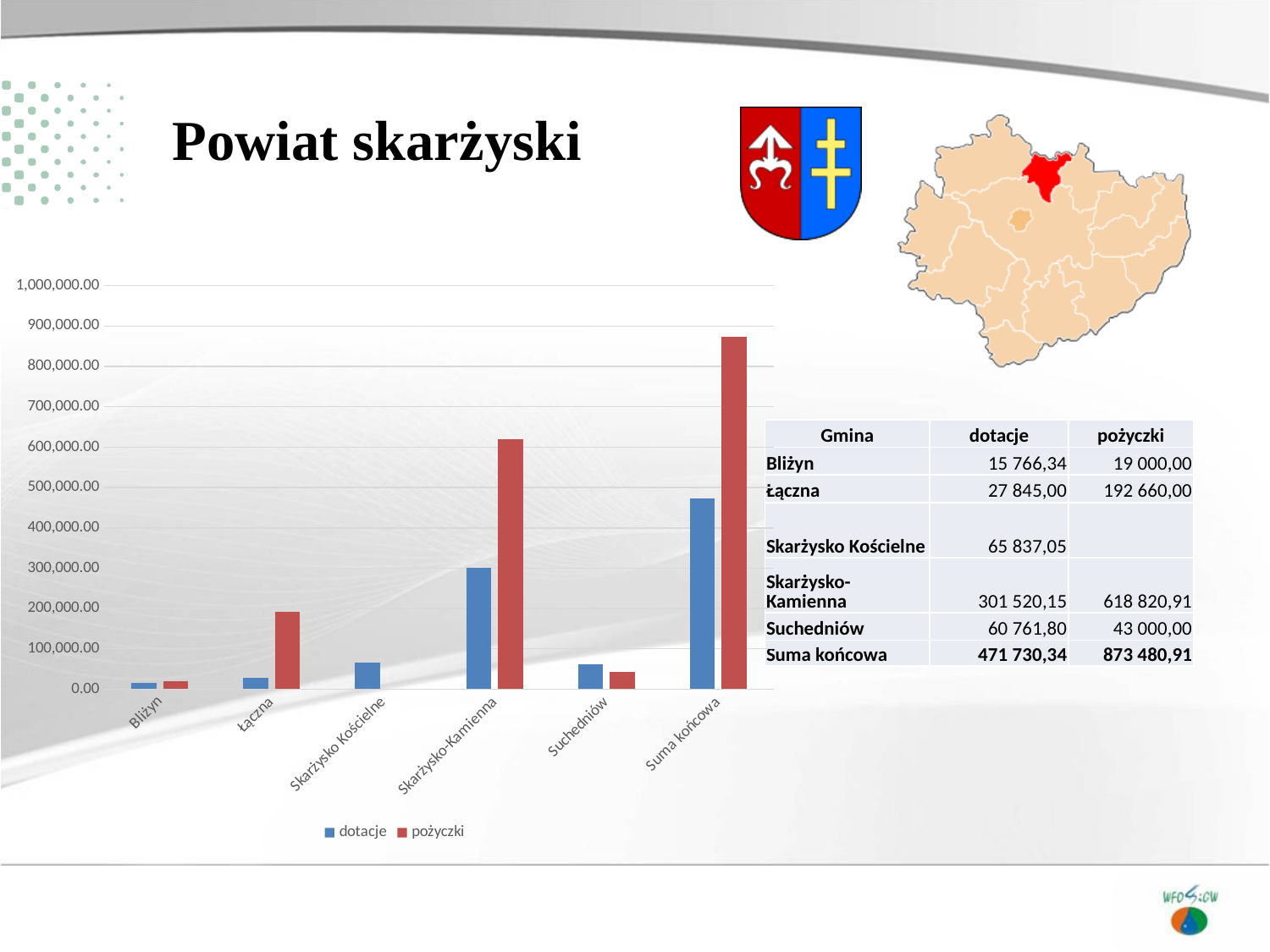
For Suchedniów, which is larger: dotacje or pożyczki? dotacje Is the dotacje value for Suma końcowa greater or less than 500,000.00? less Which category has no pożyczki bar in the chart? Skarżysko Kościelne How many categories are shown on the x axis of the chart? 6 For Łączna, which is larger: dotacje or pożyczki? pożyczki Which category has the shortest dotacje bar? Bliżyn What kind of chart is shown on the slide? bar chart Is the pożyczki value for Skarżysko-Kamienna greater or less than 600,000.00? greater Excluding Suma końcowa, which gmina has the tallest dotacje bar? Skarżysko-Kamienna According to the table on the slide, what is the dotacje value for Bliżyn? 15 766,34 How many series does the chart legend list? 2 Which category has the tallest pożyczki bar? Suma końcowa